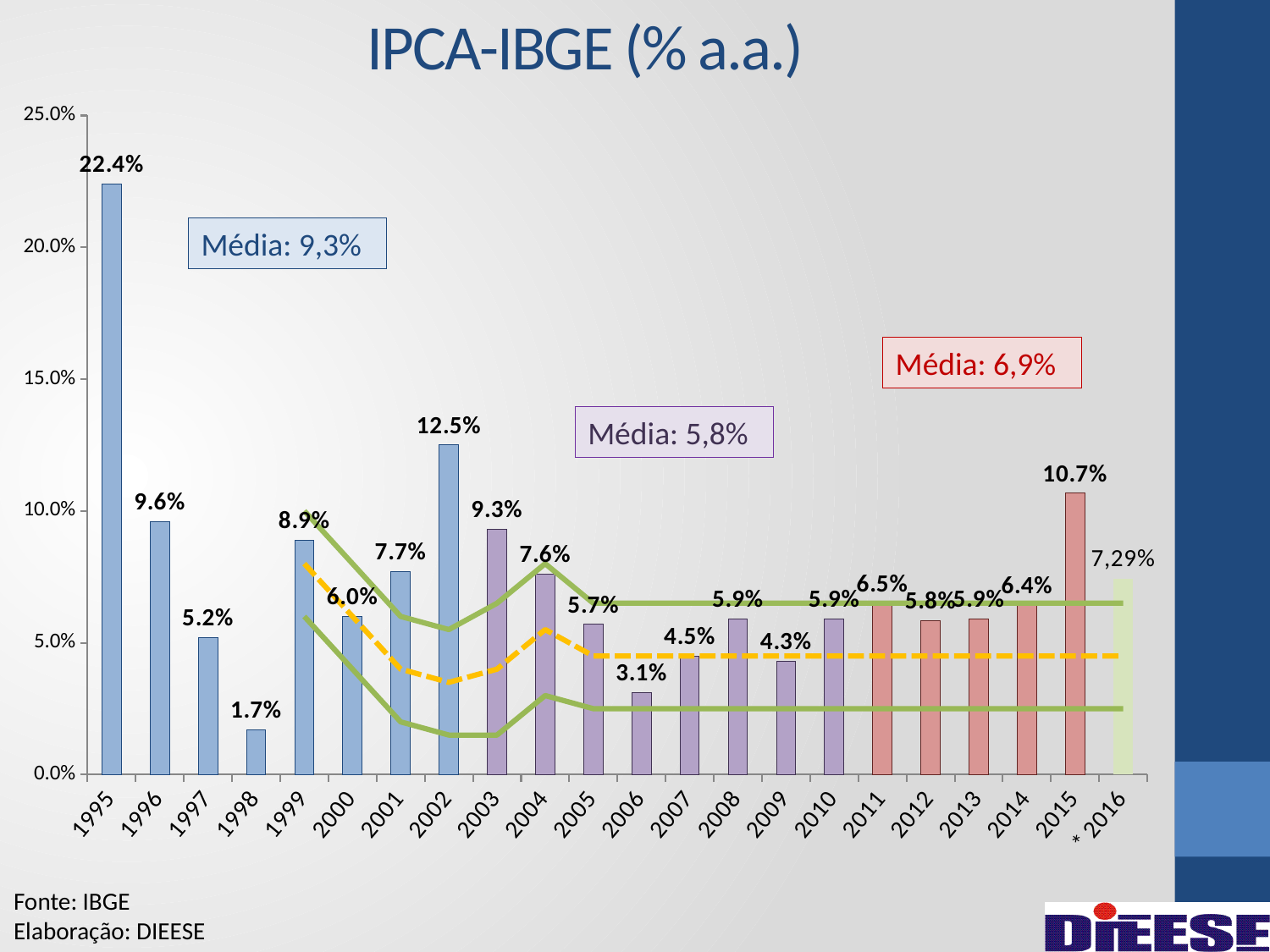
Which year has the lowest IPCA value? 1998 Do the values rise or fall from 1995 to 1998? fall What kind of chart is shown on the slide? combination bar and line chart What is the difference between the 2015 value and the 2014 value? 4.3 percentage points Is the value for 2006 greater or less than 5.0%? less What is the IPCA value shown for 2002? 12.5% What is the value labelled for 2016? 7,29% What is the IPCA value shown for 2015? 10.7% Which year has the highest IPCA value? 1995 How many years are shown on the x axis? 22 What is the IPCA value shown for 1995? 22.4% Which year has the larger value, 2002 or 2003? 2002